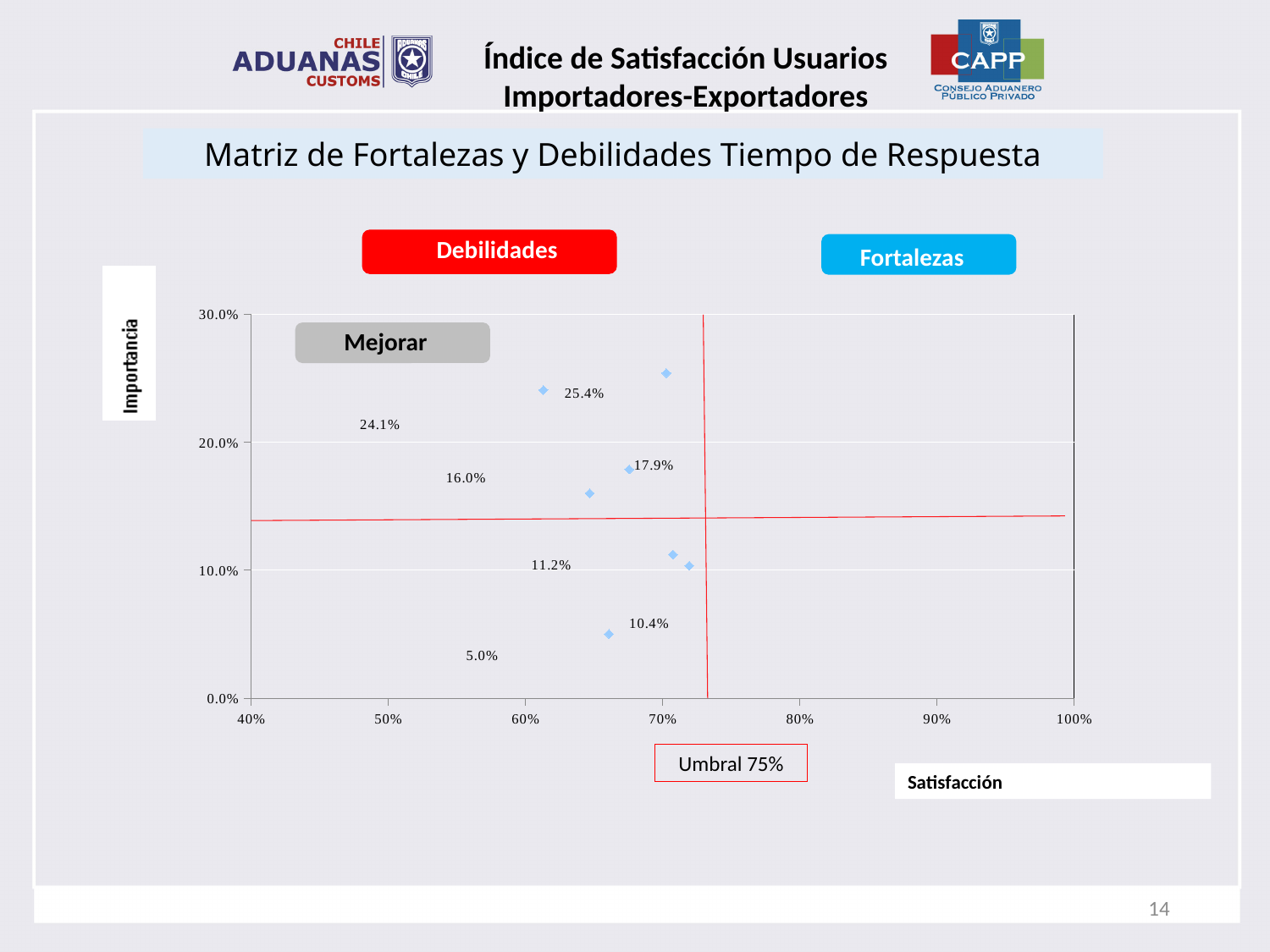
What kind of chart is shown on the slide? scatter chart What is the largest value printed as a data label on the chart? 25.4% What is the smallest value printed as a data label on the chart? 5.0% Is the importance value of the lowest data point greater or less than 10%? less What is the title of the chart? Matriz de Fortalezas y Debilidades Tiempo de Respuesta How many data points lie above the 20.0% importance gridline? 2 Is the importance value of the highest data point greater or less than 20%? greater Is the satisfaction value of the rightmost data point greater or less than 80%? less How many data points are plotted in the chart? 7 What are the labels of the x axis and the y axis of the chart? Satisfacción (x axis) and Importancia (y axis) What is the maximum value shown on the y axis of the chart? 30.0%